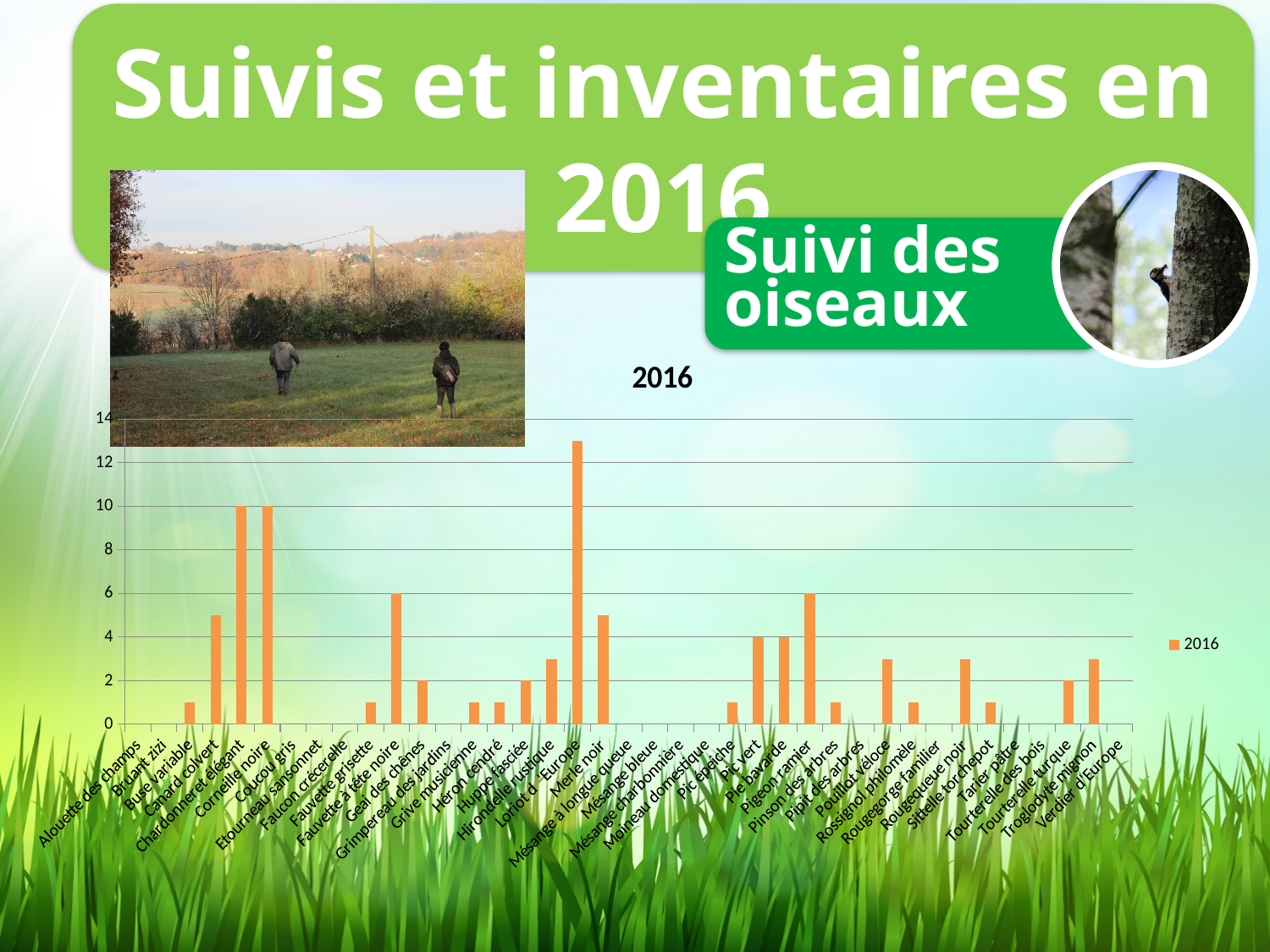
Which bird species has the highest value in the chart? Loriot d'Europe What is the value for Pigeon ramier? 6 Is the value for Loriot d'Europe greater or less than 12? greater What is the value for Corneille noire? 10 What is the difference between the values for Chardonneret élégant and Pigeon ramier? 4 How many series does the chart legend list? 1 What is the title of the chart? 2016 Is the value for Merle noir greater or less than 4? greater What is the value for Pic vert? 4 What type of chart is shown on the slide? bar chart Which is larger, the value for Chardonneret élégant or the value for Fauvette à tête noire? Chardonneret élégant What is the value for Chardonneret élégant? 10